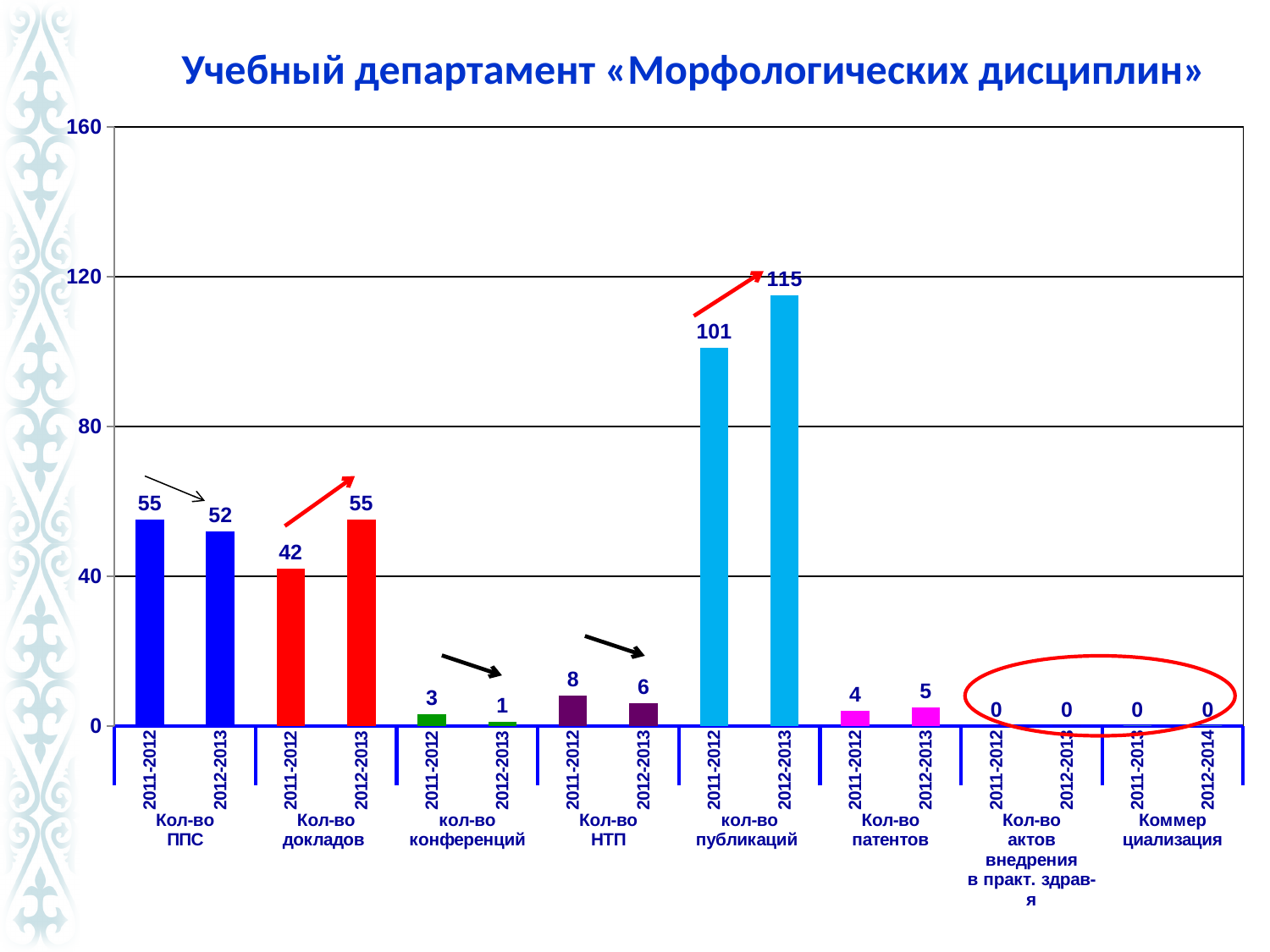
What is the difference between the Кол-во докладов values for 2012-2013 and 2011-2012? 13 What is the value for Кол-во патентов in 2011-2012? 4 Is the value for кол-во публикаций in 2011-2012 greater or less than 80? greater Which is larger: Кол-во НТП in 2011-2012 or in 2012-2013? 2011-2012 What is the value for кол-во публикаций in 2012-2013? 115 What kind of chart is shown on the slide? bar chart What is the difference between the кол-во публикаций values for 2012-2013 and 2011-2012? 14 Which bar has the highest value on the chart? кол-во публикаций, 2012-2013 How many category groups are shown along the x axis? 8 What is the value for Кол-во ППС in 2012-2013? 52 What is the value for Кол-во докладов in 2011-2012? 42 What is the title of the slide? Учебный департамент «Морфологических дисциплин»